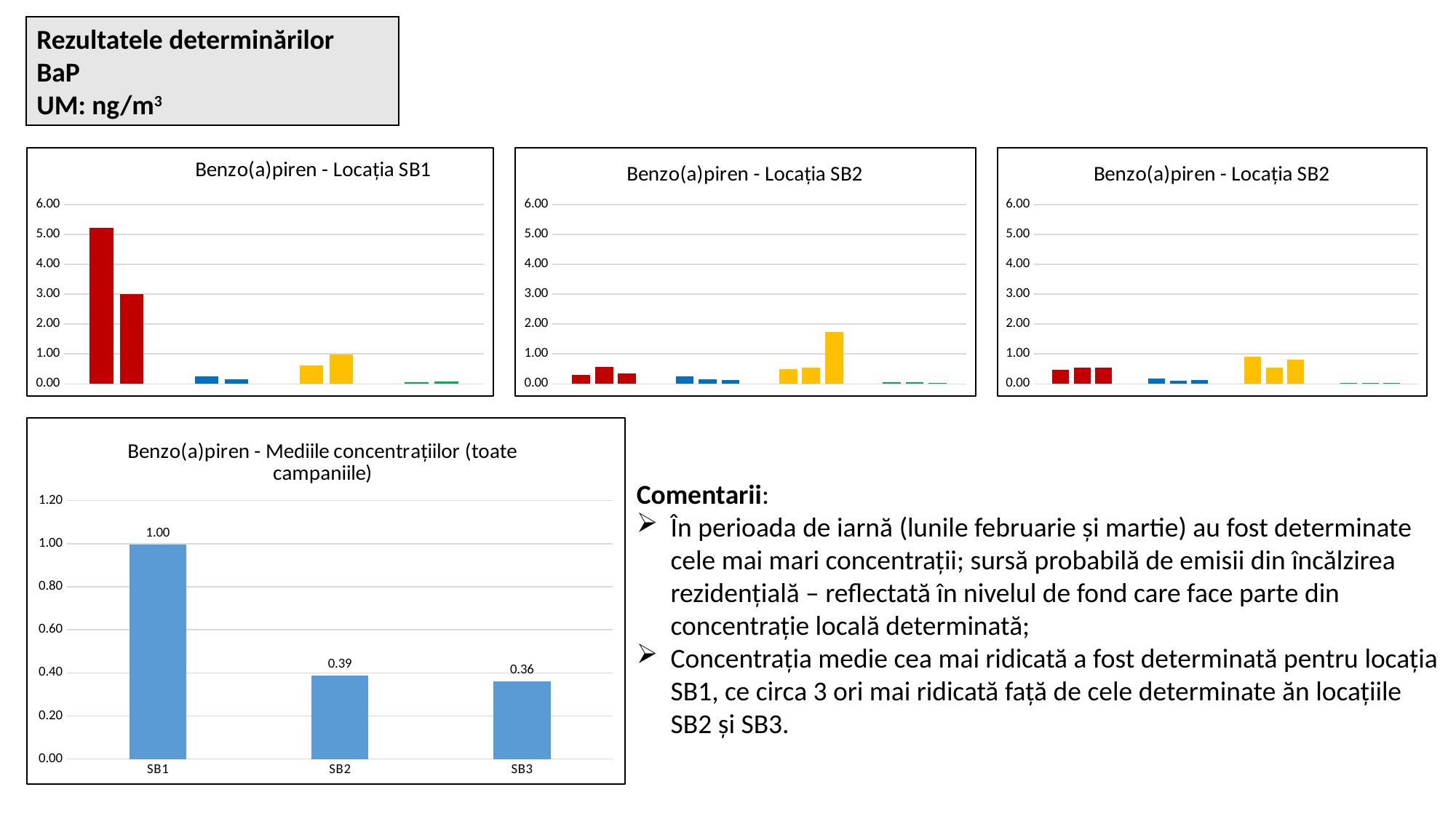
In the chart titled 'Benzo(a)piren - Mediile concentrațiilor (toate campaniile)', what is the difference between the values for SB2 and SB3? 0.03 How many locations are shown in the chart titled 'Benzo(a)piren - Mediile concentrațiilor (toate campaniile)'? 3 In the chart titled 'Benzo(a)piren - Mediile concentrațiilor (toate campaniile)', what is the difference between the values for SB1 and SB2? 0.61 In the chart titled 'Benzo(a)piren - Mediile concentrațiilor (toate campaniile)', which location has the highest value? SB1 In the chart titled 'Benzo(a)piren - Mediile concentrațiilor (toate campaniile)', what is the value for SB1? 1.00 In the chart titled 'Benzo(a)piren - Mediile concentrațiilor (toate campaniile)', what is the value for SB2? 0.39 In the top-middle chart titled 'Benzo(a)piren - Locația SB2', is the value of the tallest bar greater or less than 1.00? greater In the chart titled 'Benzo(a)piren - Mediile concentrațiilor (toate campaniile)', which location has the lowest value? SB3 In the top-left chart titled 'Benzo(a)piren - Locația SB1', is the value of the tallest bar greater or less than 5.00? greater In the chart titled 'Benzo(a)piren - Mediile concentrațiilor (toate campaniile)', what is the value for SB3? 0.36 In the chart titled 'Benzo(a)piren - Mediile concentrațiilor (toate campaniile)', which is larger, the value for SB2 or SB3? SB2 What kind of chart is the chart titled 'Benzo(a)piren - Locația SB1' in the top left? bar chart